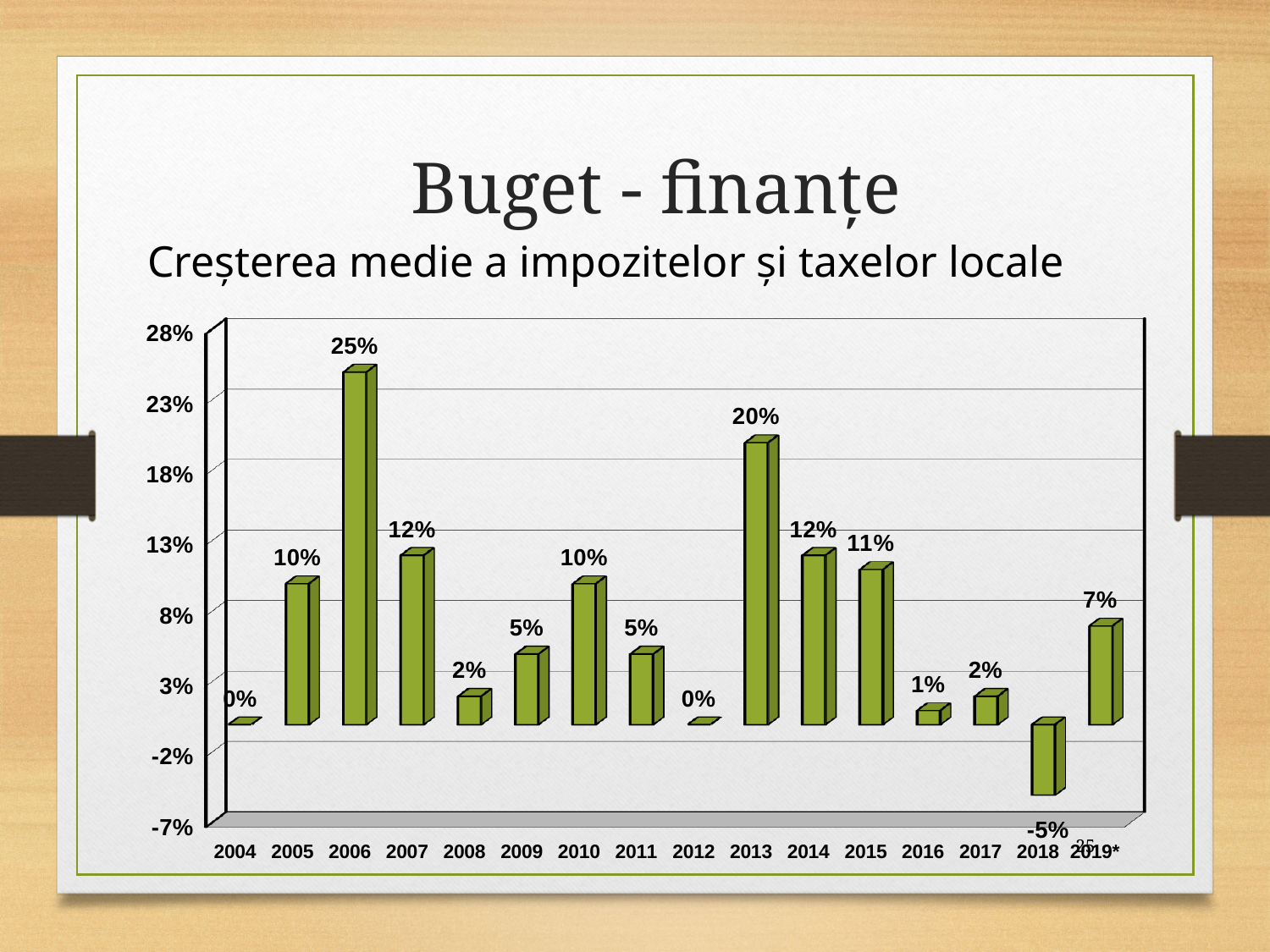
Which is larger, the value for 2014 or the value for 2015? 2014 What is the value for 2006? 25% What kind of chart is this? bar chart What is the value for 2019*? 7% What is the subtitle of the chart? Creșterea medie a impozitelor și taxelor locale Which year has the lowest value? 2018 What is the difference between the values for 2006 and 2013? 5% Do the values rise or fall from 2013 to 2016? fall How many years are shown on the x axis? 16 What is the value for 2018? -5% What is the value for 2013? 20% Which year has the highest value? 2006